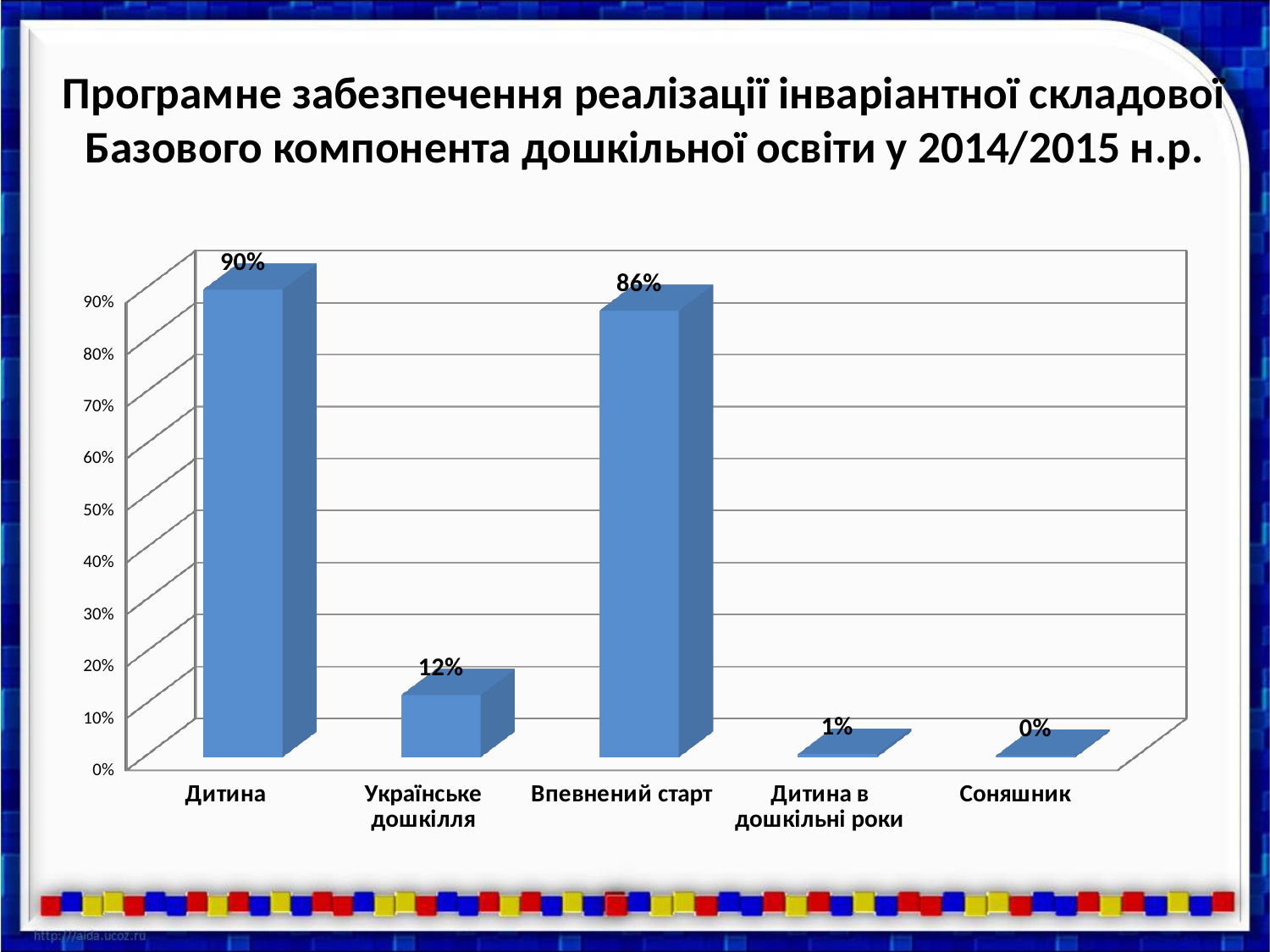
What is the value for Дитина? 90% Which category has the highest value? Дитина What is the difference between the values for Дитина and Впевнений старт? 4% Which is larger, the value for Українське дошкілля or the value for Дитина в дошкільні роки? Українське дошкілля What is the value for Впевнений старт? 86% What is the difference between the values for Впевнений старт and Українське дошкілля? 74% What is the value for Українське дошкілля? 12% What kind of chart is shown on the slide? Bar chart How many categories are shown on the x axis? 5 What is the value for Соняшник? 0% Which category has the lowest value? Соняшник What is the value for Дитина в дошкільні роки? 1%